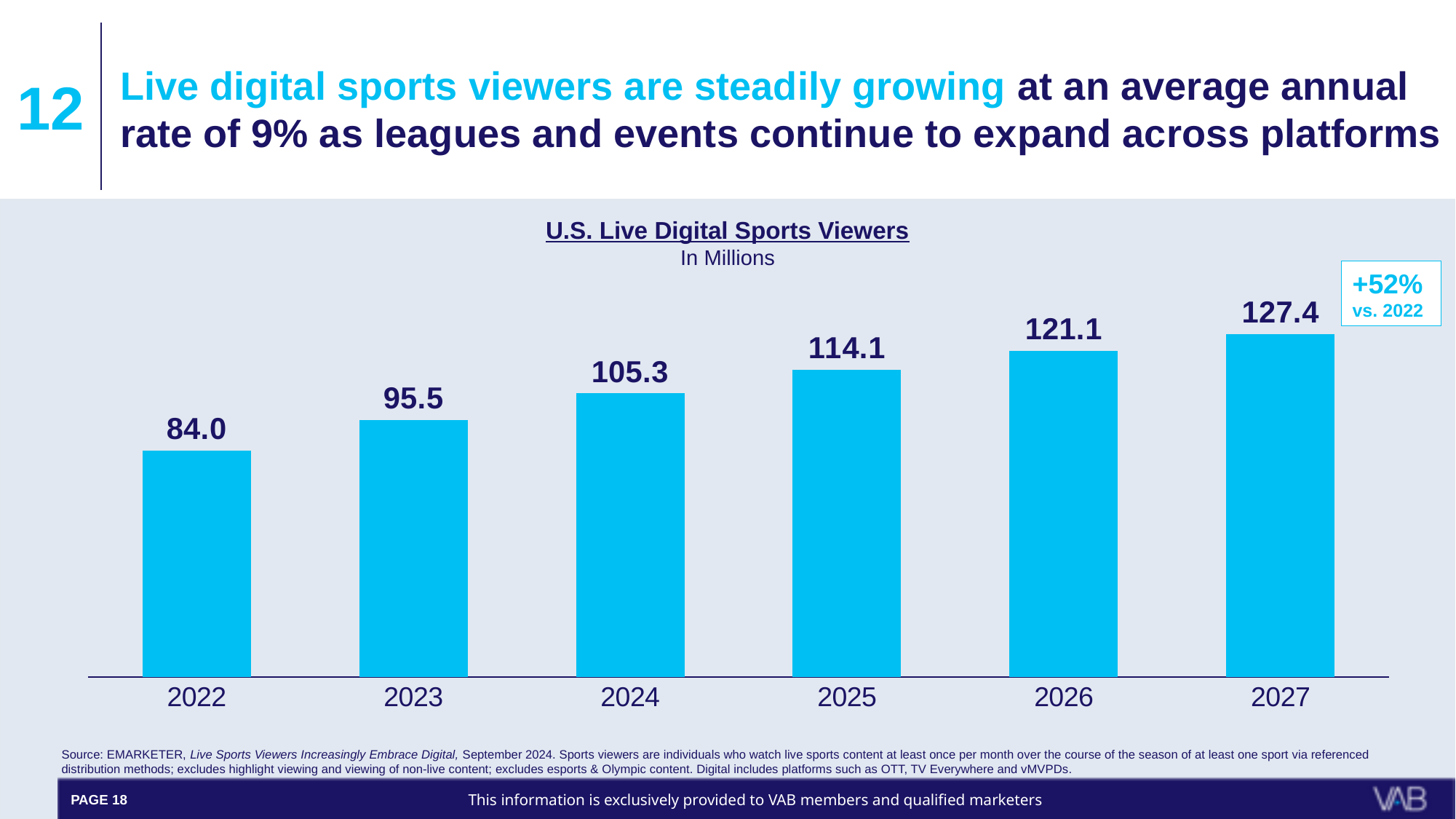
Which year has the highest value in the U.S. Live Digital Sports Viewers chart? 2027 Which year has the lowest value in the U.S. Live Digital Sports Viewers chart? 2022 What is the value for 2022 in the U.S. Live Digital Sports Viewers chart? 84.0 Do the values in the U.S. Live Digital Sports Viewers chart rise or fall from 2022 to 2027? Rise What is the difference between the 2027 and 2022 values in the U.S. Live Digital Sports Viewers chart? 43.4 What is the value for 2025 in the U.S. Live Digital Sports Viewers chart? 114.1 How many years are shown in the U.S. Live Digital Sports Viewers chart? 6 What kind of chart is the U.S. Live Digital Sports Viewers chart? Bar chart What is the value for 2027 in the U.S. Live Digital Sports Viewers chart? 127.4 What unit is stated under the title of the U.S. Live Digital Sports Viewers chart? In Millions Which is larger in the U.S. Live Digital Sports Viewers chart, the value for 2026 or the value for 2024? 2026 What is the difference between the 2024 and 2023 values in the U.S. Live Digital Sports Viewers chart? 9.8